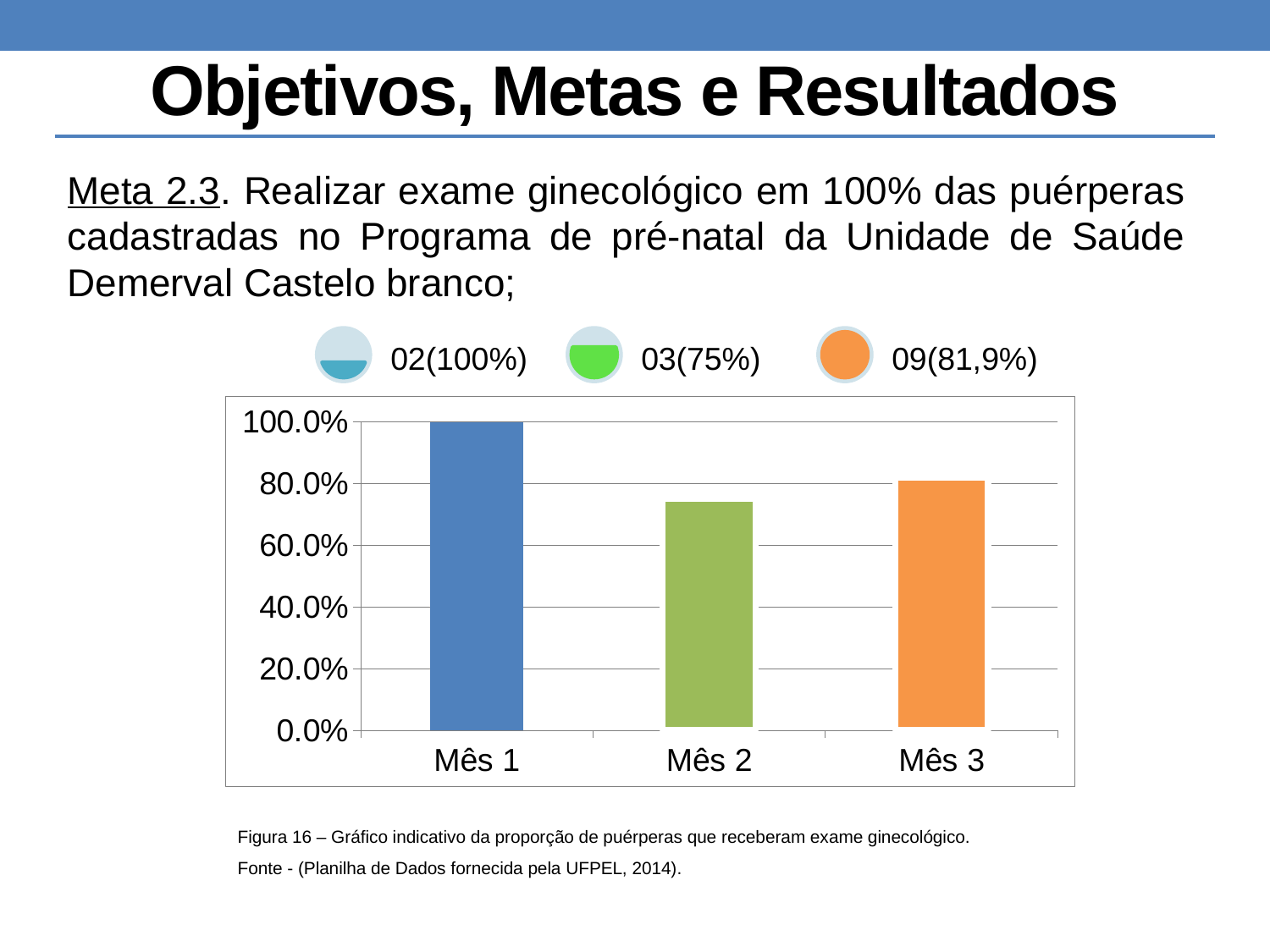
What type of chart is shown on the slide? bar chart What is the value for Mês 1 in the chart? 100.0% What colour is the bar for Mês 3? orange Is the value for Mês 2 greater or less than 60.0%? greater How many categories are shown on the x axis of the chart? 3 Is the value for Mês 3 greater or less than 80.0%? greater What is the highest tick value shown on the y axis of the chart? 100.0% Which is larger, the value for Mês 2 or the value for Mês 3? Mês 3 Which month has the lowest value in the chart? Mês 2 Is the value for Mês 2 greater or less than 80.0%? less Which is larger, the value for Mês 1 or the value for Mês 3? Mês 1 Which month has the highest value in the chart? Mês 1